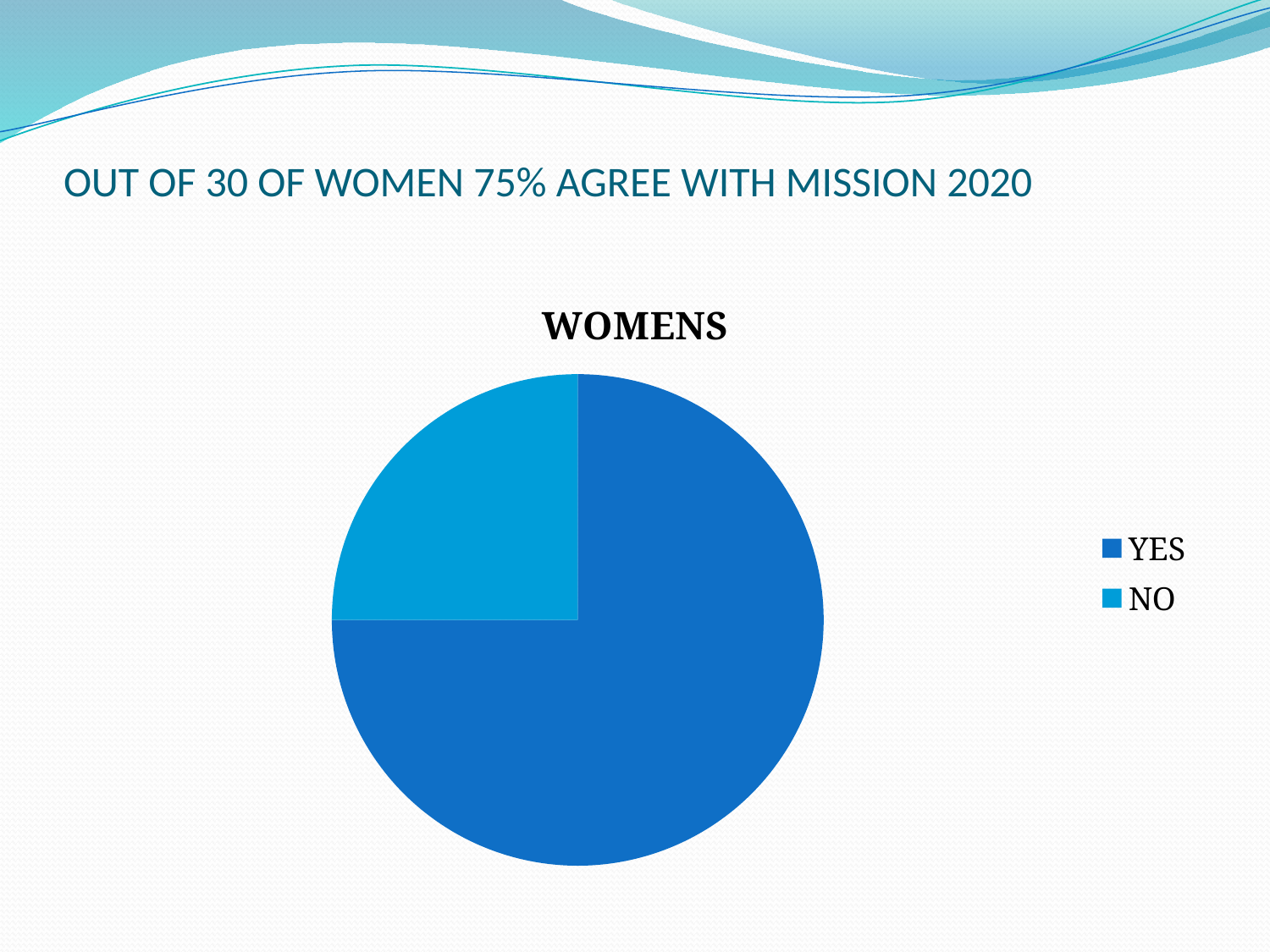
Which is larger, the YES slice or the NO slice? YES How many slices does the pie chart have? 2 What are the two legend entries of the chart? YES and NO How many entries does the legend list? 2 What share of the pie does the NO slice represent? 25% What share of the pie does the YES slice represent? 75% What kind of chart is shown on the slide? pie chart What is the title of the chart? WOMENS Which slice of the pie chart is the largest? YES Which slice of the pie chart is the smallest? NO